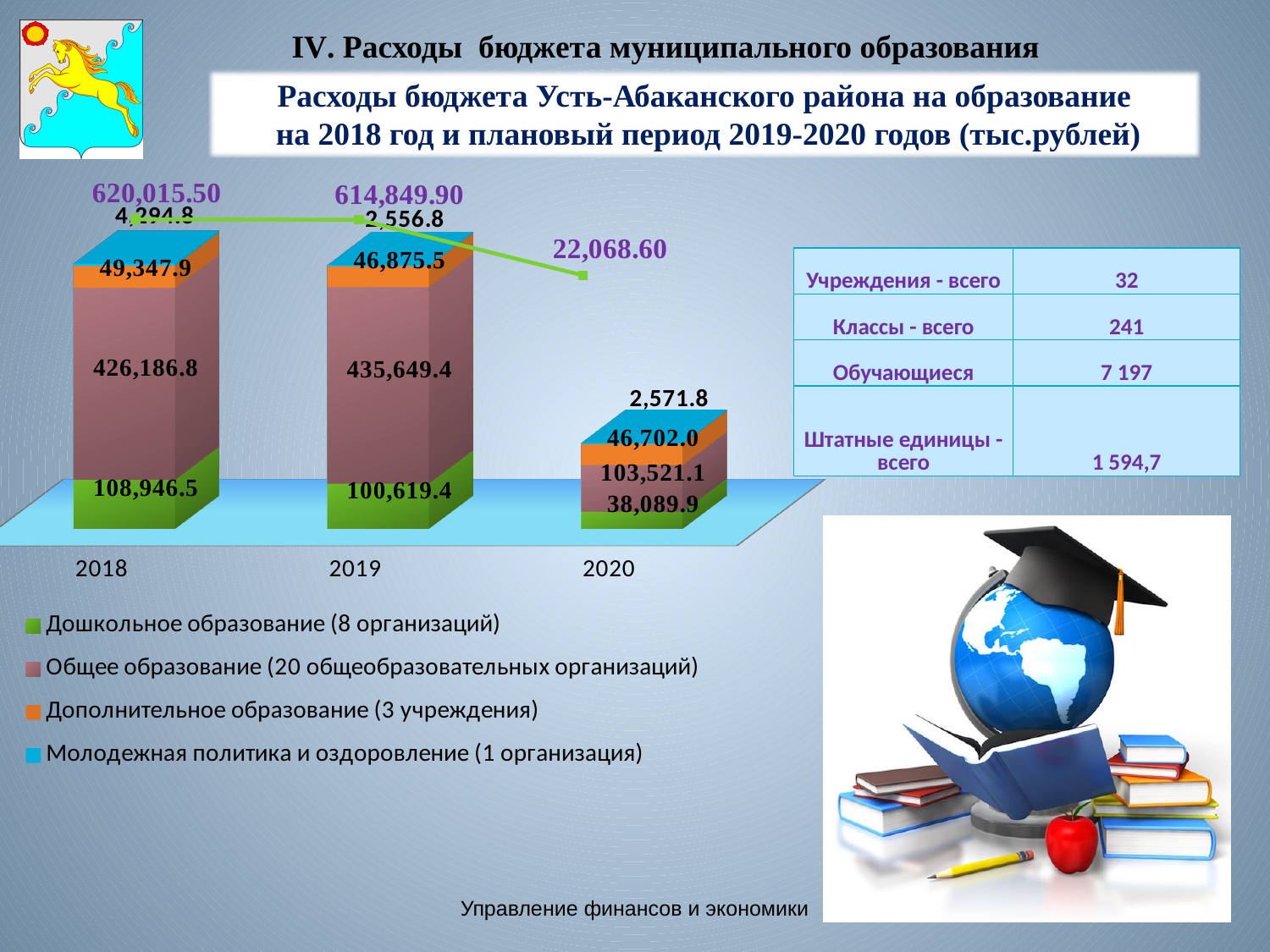
In which year is the value for Общее образование the highest? 2019 What is the value for Дополнительное образование in 2019? 46,875.5 Does the value for Дошкольное образование rise or fall from 2018 to 2020? Fall How many series does the chart legend list? 4 In which year is the value for Дошкольное образование the lowest? 2020 What is the difference between the Дошкольное образование values for 2018 and 2019? 8,327.1 How many years are shown on the x axis of the chart? 3 What is the value for Молодежная политика и оздоровление in 2020? 2,571.8 What is the value for Общее образование in 2018? 426,186.8 What is the value for Дошкольное образование in 2020? 38,089.9 Which year has the larger value for Дополнительное образование, 2019 or 2020? 2019 What kind of chart is used to show the education expenditures? Stacked bar chart